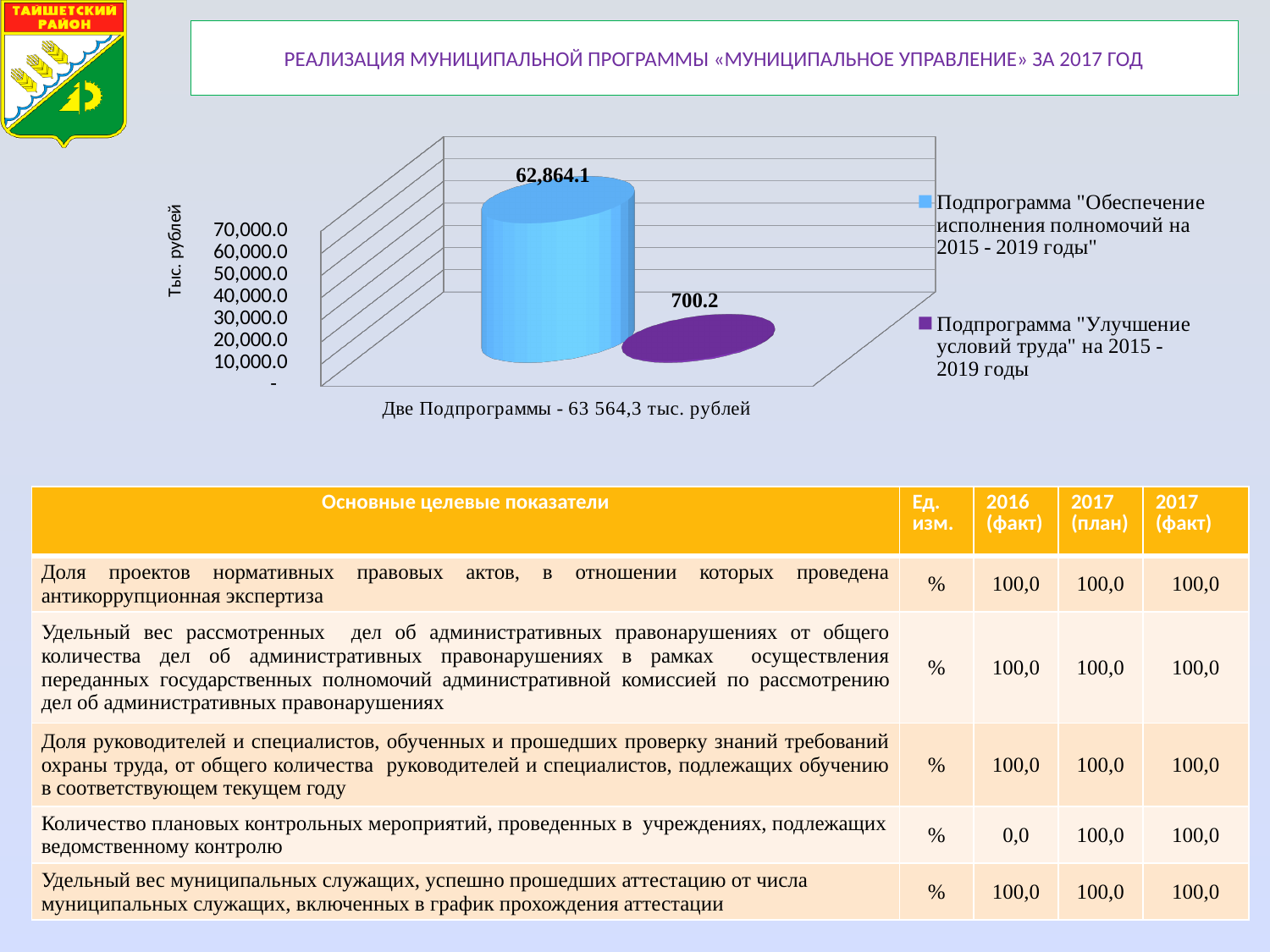
What kind of chart is shown on the slide? bar chart How many series does the chart legend list? 2 What is the difference between the values of the two subprograms? 62,163.9 What is the value for the subprogram "Улучшение условий труда" на 2015 - 2019 годы? 700.2 Is the value for "Обеспечение исполнения полномочий на 2015 - 2019 годы" greater or less than 60,000.0? greater Which subprogram has the lowest value in the chart? Подпрограмма "Улучшение условий труда" на 2015 - 2019 годы What is the total of the two subprograms shown in the chart? 63 564,3 тыс. рублей Which subprogram has the highest value in the chart? Подпрограмма "Обеспечение исполнения полномочий на 2015 - 2019 годы" What is the value for the subprogram "Обеспечение исполнения полномочий на 2015 - 2019 годы"? 62,864.1 Is the value for "Улучшение условий труда" на 2015 - 2019 годы greater or less than 10,000.0? less Which is larger: the value for "Обеспечение исполнения полномочий" or for "Улучшение условий труда"? Обеспечение исполнения полномочий What unit is shown on the vertical axis of the chart? Тыс. рублей